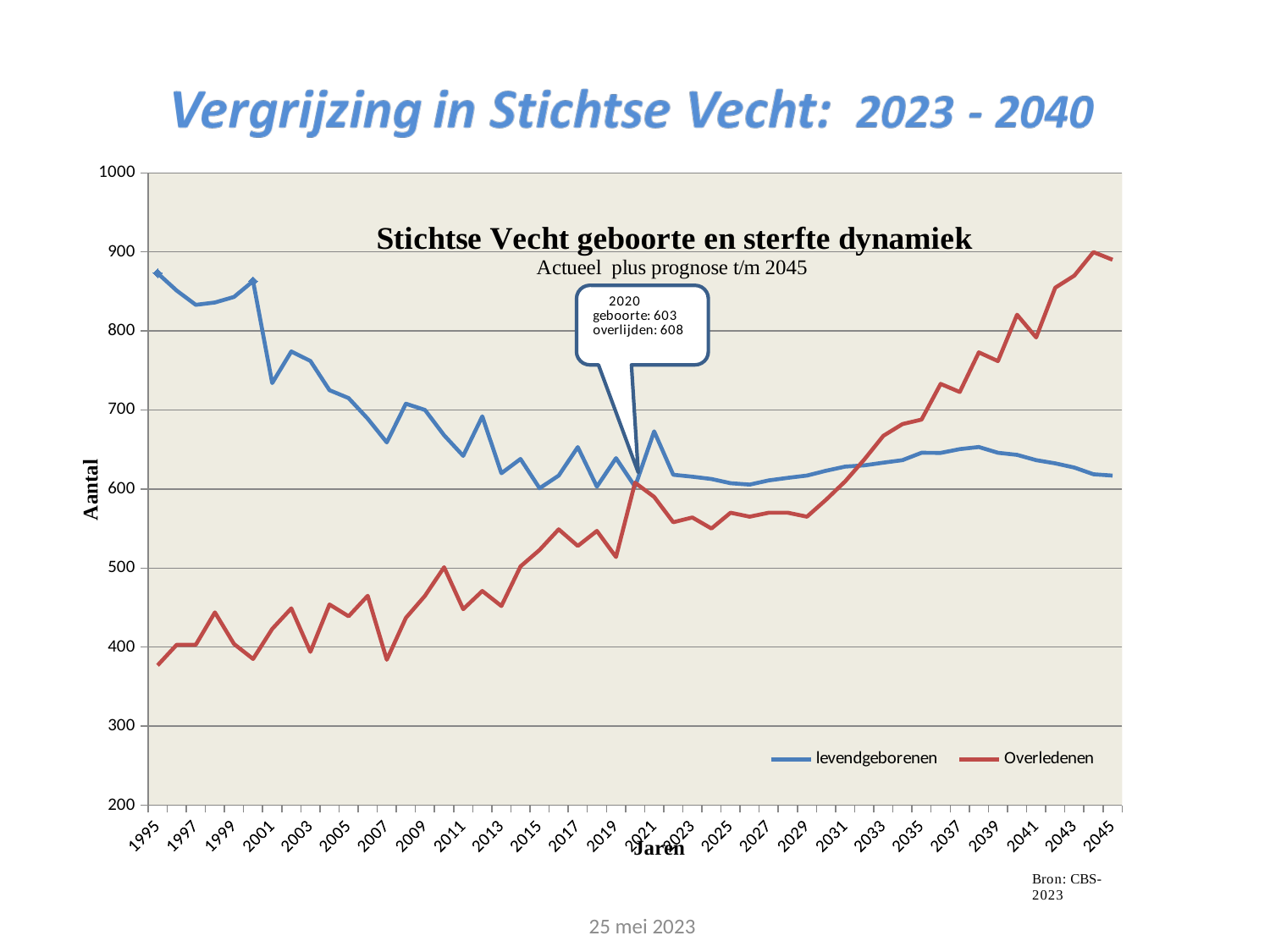
What is the difference between deaths and births in 2020 according to the callout? 5 According to the callout, what is the number of births (geboorte) in 2020? 603 In 2020, which is larger according to the callout: geboorte or overlijden? overlijden Does the Overledenen line generally rise or fall from 1995 to 2045? rise In 2045, which series has the higher value: levendgeborenen or Overledenen? Overledenen Is the value for Overledenen in 2045 greater or less than 800? greater According to the callout, what is the number of deaths (overlijden) in 2020? 608 What type of chart is shown on the slide? line chart Is the value for levendgeborenen in 1995 greater or less than 800? greater What is the title of the chart? Stichtse Vecht geboorte en sterfte dynamiek Is the value for Overledenen in 1995 greater or less than 400? less How many series does the legend list? 2